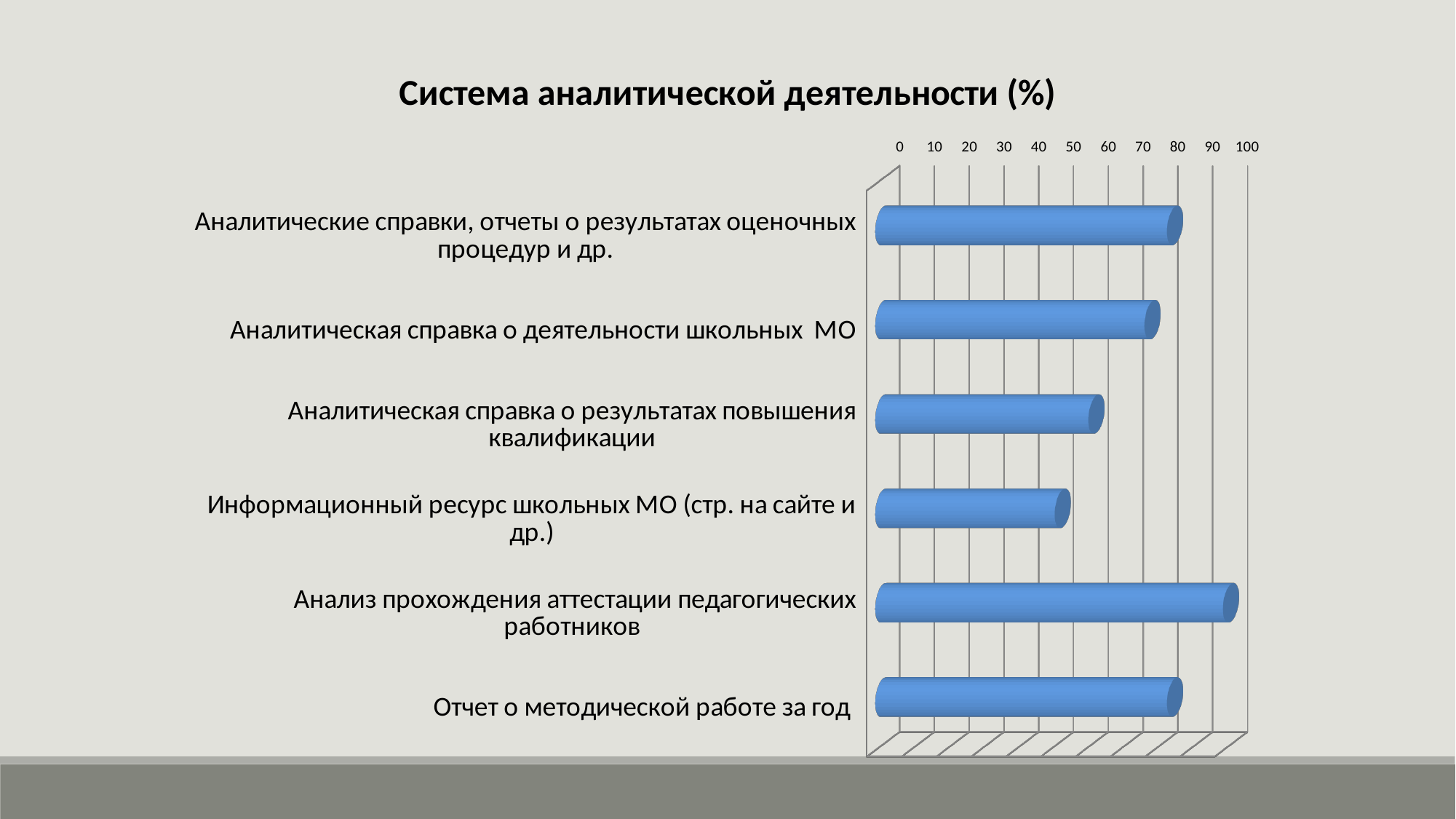
Which category has the lowest value? Информационный ресурс школьных МО (стр. на сайте и др.) What is the maximum value shown on the horizontal axis? 100 What is the title of the chart? Система аналитической деятельности (%) Which is larger: the value for "Аналитическая справка о деятельности школьных МО" or for "Аналитическая справка о результатах повышения квалификации"? Аналитическая справка о деятельности школьных МО Which category has the highest value? Анализ прохождения аттестации педагогических работников Is the value for "Аналитическая справка о результатах повышения квалификации" greater or less than 70? less Is the value for "Аналитические справки, отчеты о результатах оценочных процедур и др." greater or less than 70? greater Is the value for "Информационный ресурс школьных МО (стр. на сайте и др.)" greater or less than 60? less How many categories are plotted in the chart? 6 What kind of chart is shown on the slide? bar chart